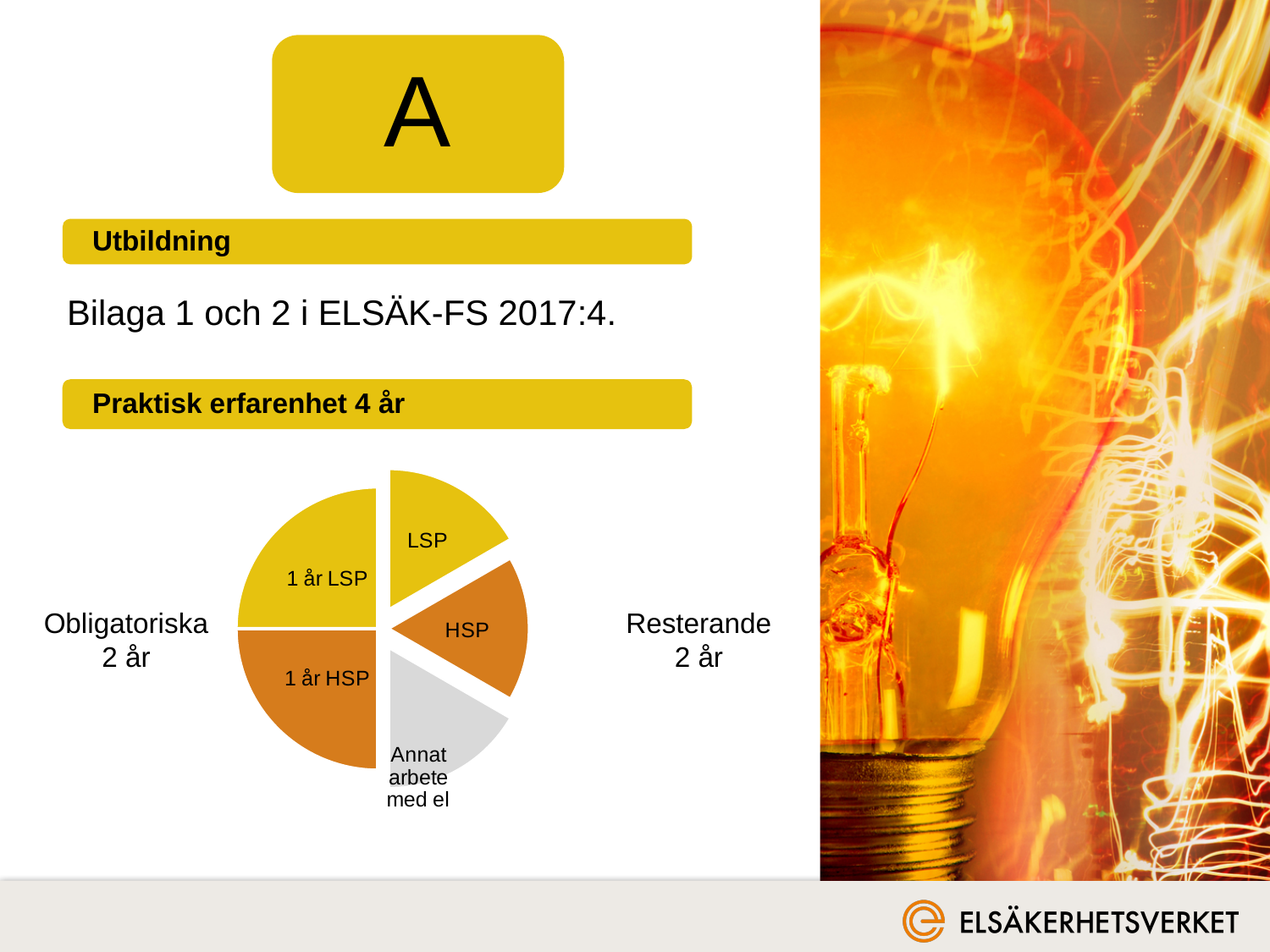
How many years does the '1 år HSP' slice represent? 1 år How many slices does the pie chart have? 5 Which slice is larger, '1 år HSP' or 'Annat arbete med el'? 1 år HSP What is the title shown above the pie chart? Praktisk erfarenhet 4 år How many years does the '1 år LSP' slice represent? 1 år Which slice is larger, '1 år HSP' or 'HSP'? 1 år HSP What kind of chart is shown on the slide? pie chart Which slice of the pie chart is grey? Annat arbete med el Which label is shown to the left of the pie chart? Obligatoriska 2 år Which slice is larger, '1 år LSP' or 'LSP'? 1 år LSP What share of the 4-year total does the '1 år LSP' slice represent? 25%